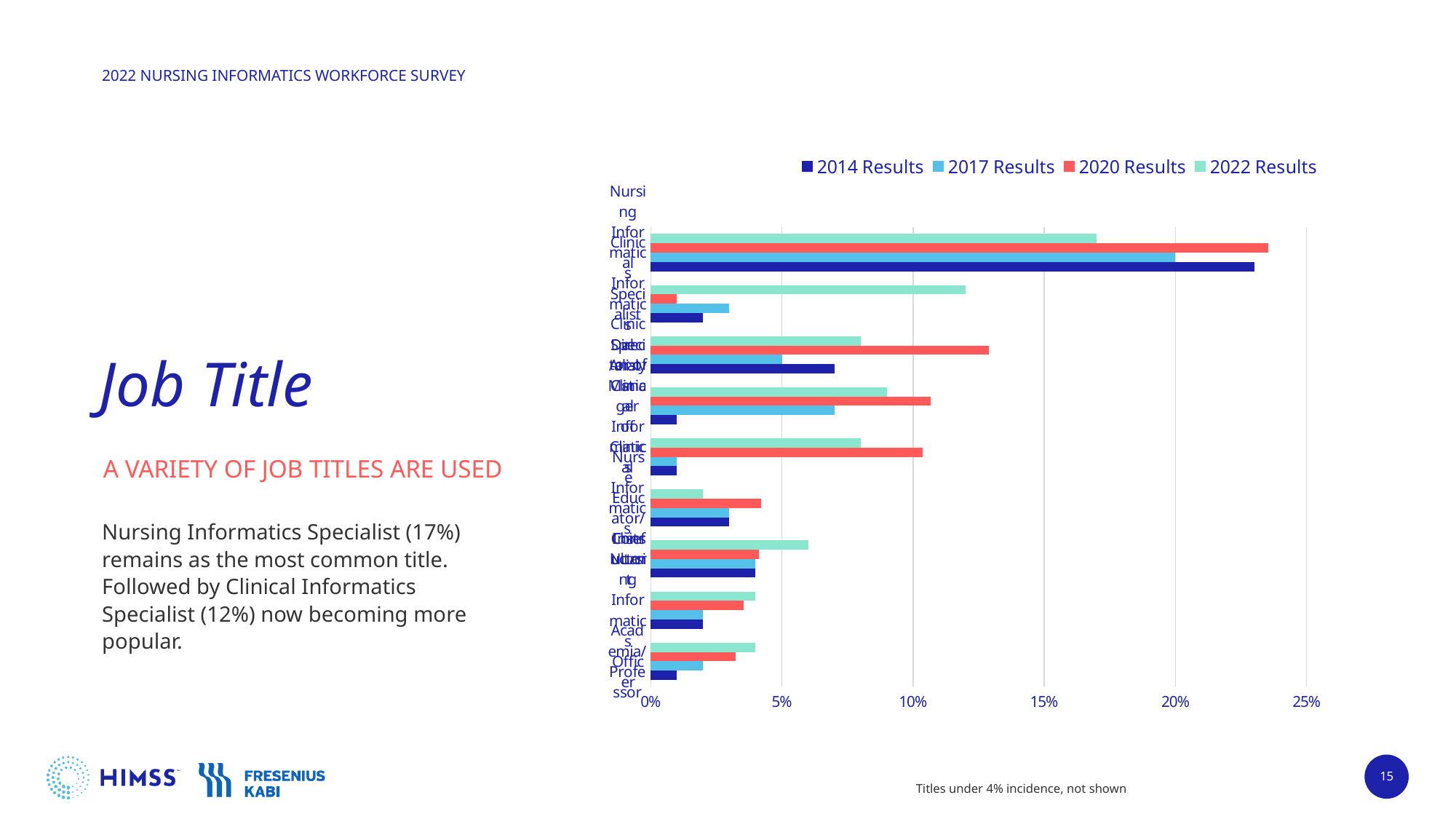
How many job title categories are plotted in the chart? 9 How many series does the chart legend list? 4 What is the highest tick label shown on the chart's horizontal axis? 25% For Nursing Informatics Specialist, which is larger: the 2014 Results value or the 2022 Results value? 2014 Results Is the 2022 Results value for Nursing Informatics Specialist greater or less than 15%? greater Is the 2020 Results value for Clinical Informatics Specialist greater or less than 5%? less What are the series names listed in the chart legend? 2014 Results, 2017 Results, 2020 Results, 2022 Results Is the 2022 Results value for Clinical Informatics Specialist greater or less than 10%? greater What kind of chart is shown on the slide? Bar chart Which job title has the highest 2022 Results value in the chart? Nursing Informatics Specialist For Clinical Informatics Specialist, which is larger: the 2017 Results value or the 2022 Results value? 2022 Results